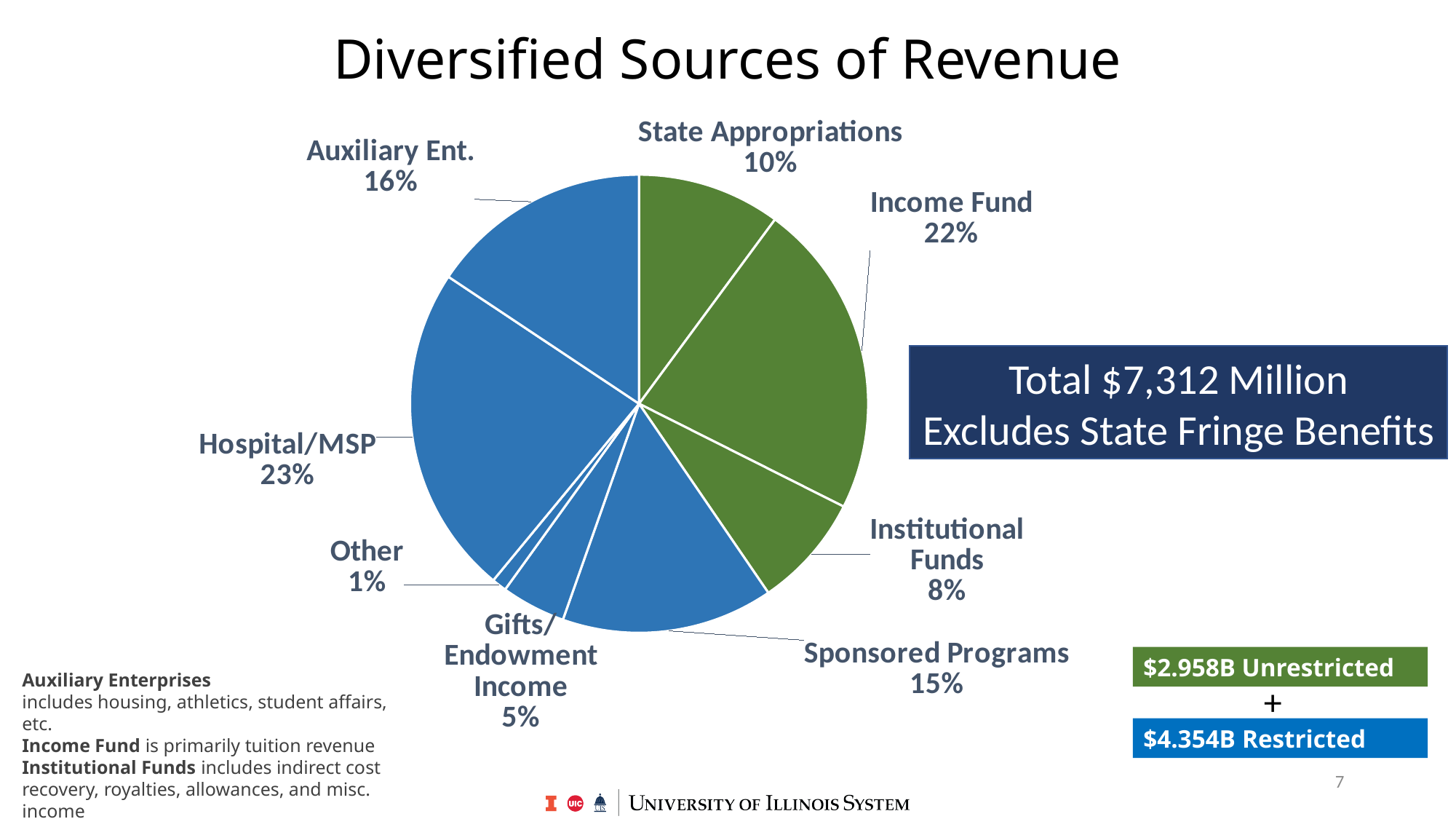
Which revenue source has the smallest share of the pie? Other What is the difference in percentage points between Auxiliary Ent. and Institutional Funds? 8 What kind of chart is shown on the slide? pie chart What is the title of the slide's chart? Diversified Sources of Revenue What percentage of revenue is Hospital/MSP? 23% What percentage of revenue is Sponsored Programs? 15% How many slices does the pie chart have? 8 What share of revenue comes from State Appropriations? 10% Which revenue source has the largest share of the pie? Hospital/MSP Which is larger, Income Fund or Sponsored Programs? Income Fund What share of revenue comes from the Income Fund? 22% What is the combined share of Gifts/Endowment Income and Other? 6%